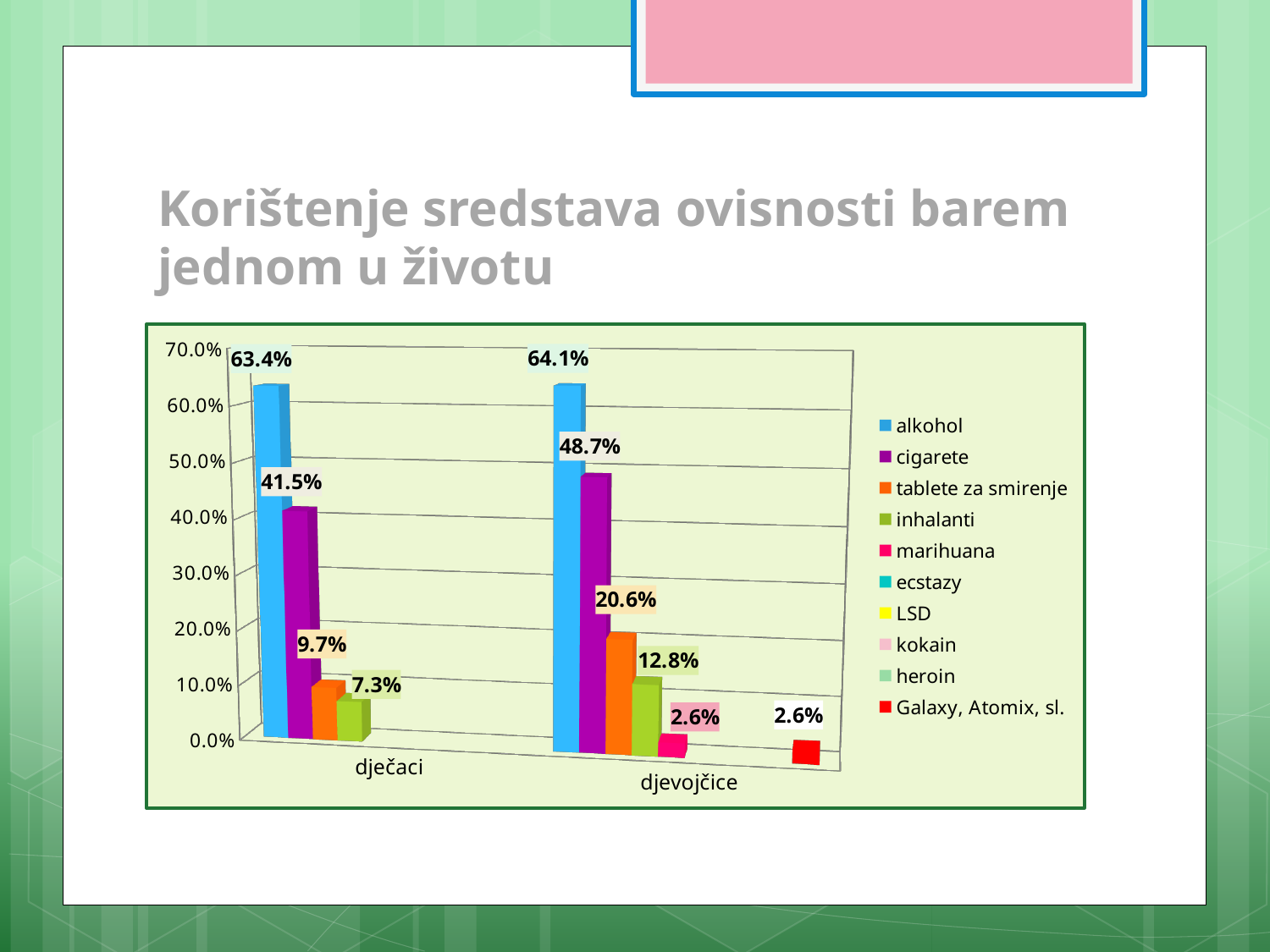
What kind of chart is shown on the slide? bar chart Which labelled series has the lowest value in the dječaci category? inhalanti What is the value for cigarete in the djevojčice category? 48.7% What is the difference between the cigarete values for djevojčice and dječaci? 7.2% What is the value for alkohol in the dječaci category? 63.4% What is the value for marihuana in the djevojčice category? 2.6% What is the value for inhalanti in the dječaci category? 7.3% Which is larger, the tablete za smirenje value for dječaci or for djevojčice? djevojčice How many series does the legend list? 10 Which series has the highest value in the djevojčice category? alkohol How many categories are shown on the x axis? 2 What is the value for tablete za smirenje in the djevojčice category? 20.6%